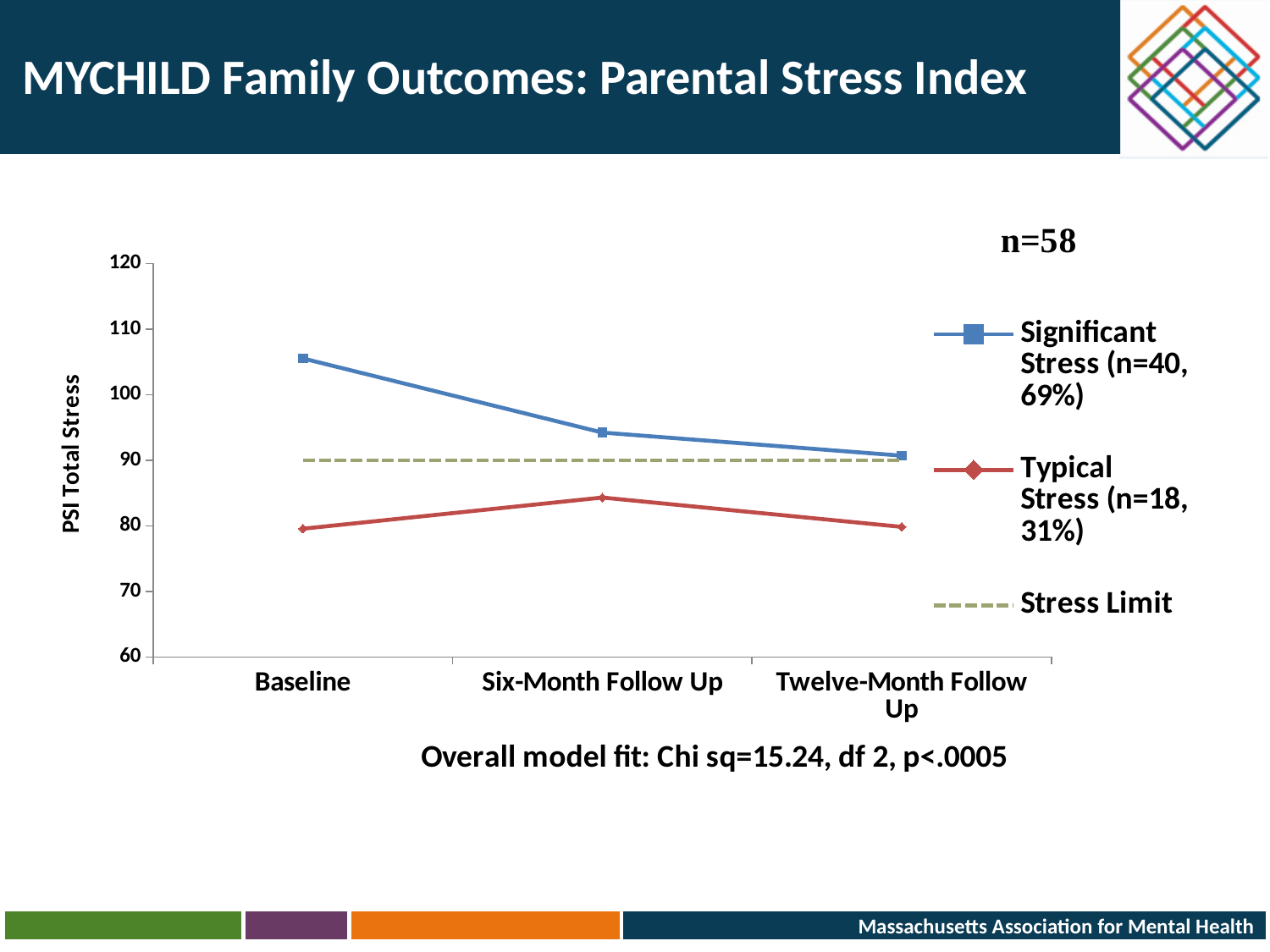
At Baseline, which is larger: Significant Stress or Typical Stress? Significant Stress What kind of chart is shown on the slide? Line chart How many series does the legend list? 3 Is the Typical Stress value at Six-Month Follow Up greater or less than 80? greater Does the Significant Stress line rise or fall from Baseline to Twelve-Month Follow Up? Fall At which time point is the Significant Stress value lowest? Twelve-Month Follow Up What is the label on the y axis of the chart? PSI Total Stress How many time points are shown on the x axis? 3 At which time point is the Significant Stress value highest? Baseline Is the Significant Stress value at Baseline greater or less than 100? greater Is the Significant Stress value at Six-Month Follow Up greater or less than 100? less At which time point is the Typical Stress value highest? Six-Month Follow Up